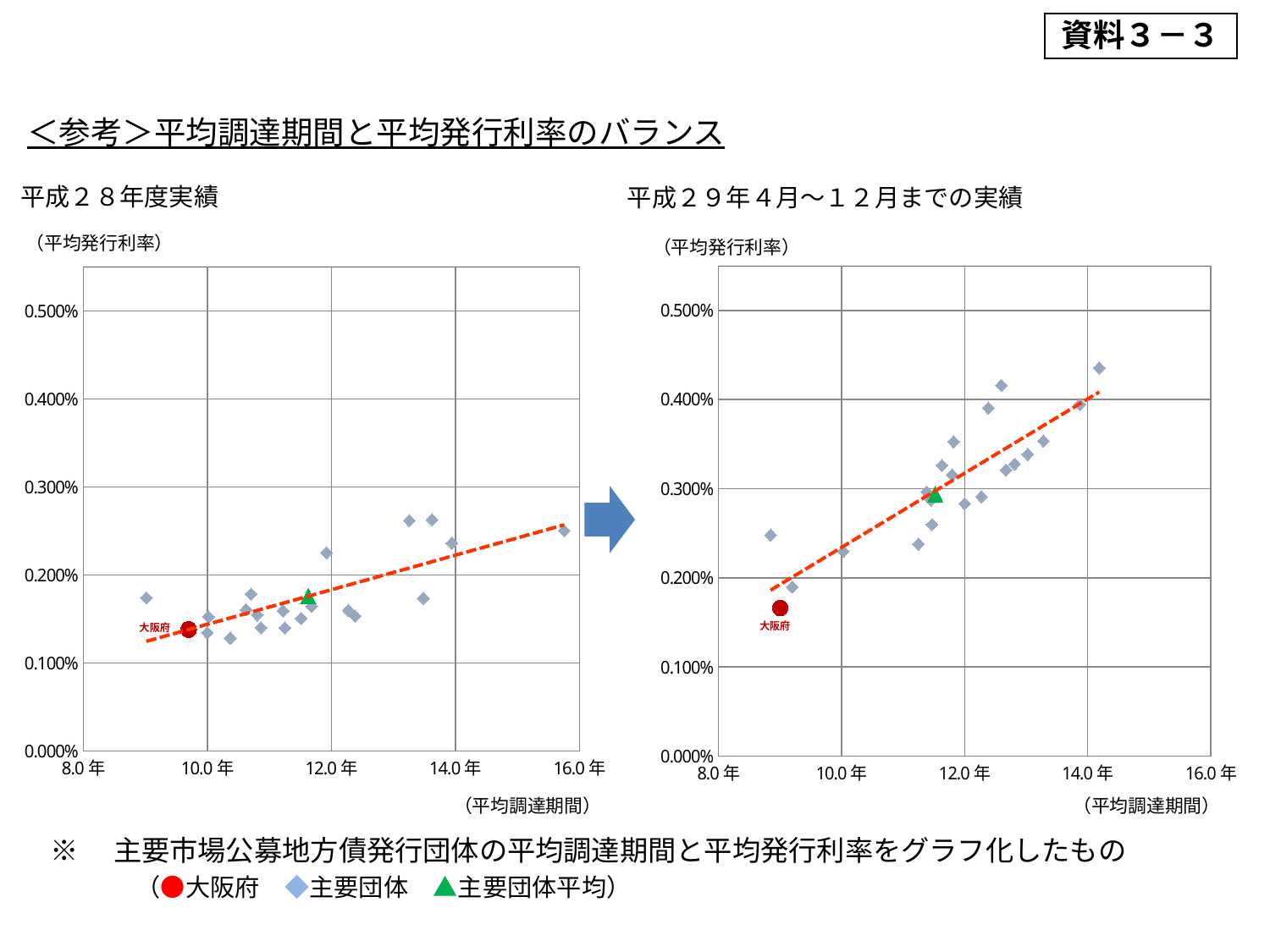
In the left chart (平成28年度実績), is the highest 主要団体 point greater or less than 0.300%? less In the left chart (平成28年度実績), is the 平均発行利率 for 大阪府 greater or less than 0.200%? less In the right chart (平成29年4月～12月までの実績), does the dashed trend line rise or fall as 平均調達期間 increases? rises What is the label of the horizontal axis on both charts? 平均調達期間 In the right chart (平成29年4月～12月までの実績), which has the higher 平均発行利率, 大阪府 or 主要団体平均? 主要団体平均 In the left chart (平成28年度実績), is the 平均調達期間 for 大阪府 greater or less than 10.0年? less In the left chart (平成28年度実績), which has the higher 平均発行利率, 大阪府 or 主要団体平均? 主要団体平均 What kind of chart is the left chart (平成28年度実績)? scatter chart How many series does the legend at the bottom of the slide list? 3